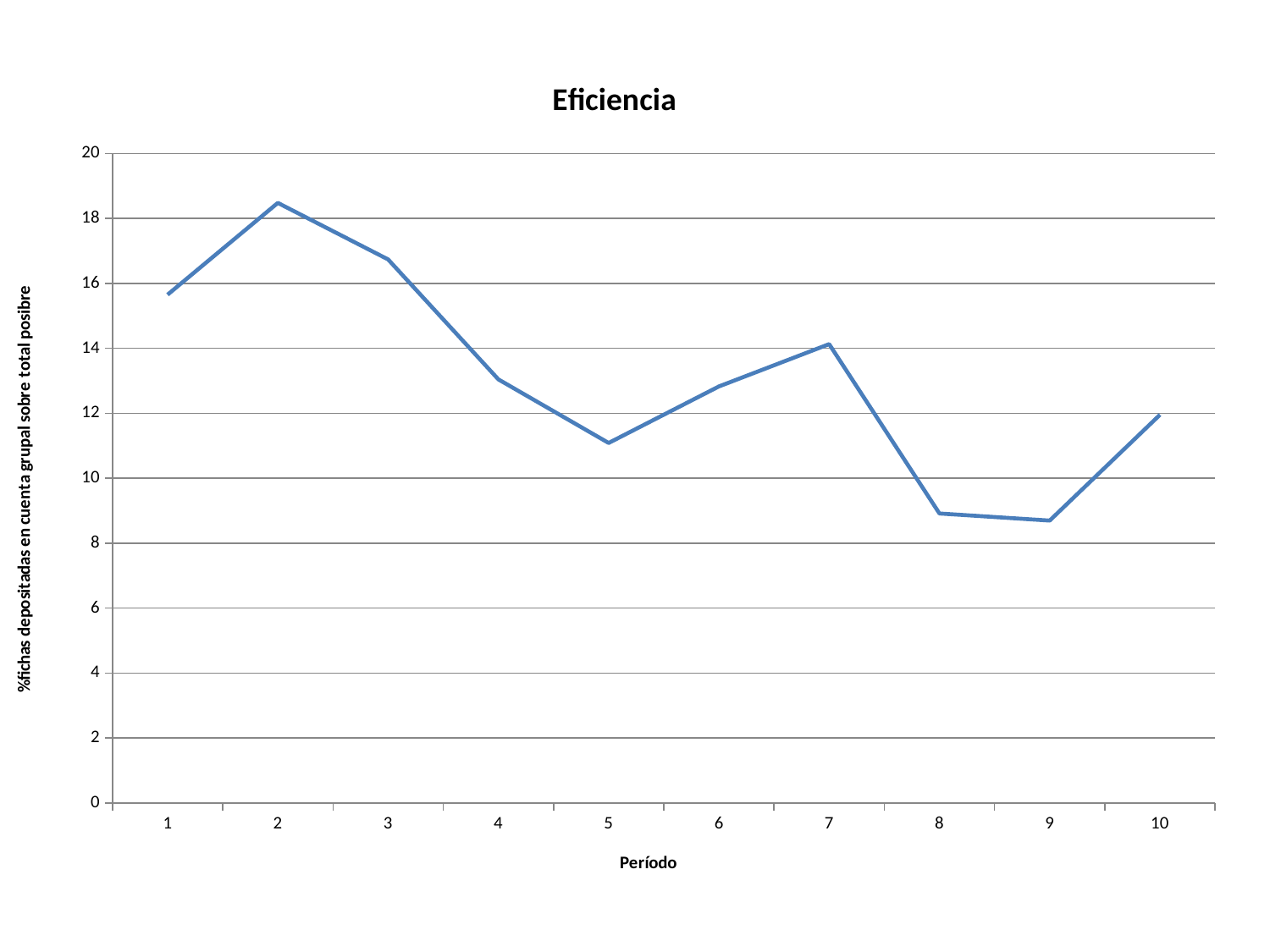
What is the label of the x axis? Período What is the title of the chart? Eficiencia How many periods are plotted on the x axis? 10 Is the value for period 2 greater or less than 18? greater Is the value for period 8 greater or less than 10? less Do the values rise or fall from period 2 to period 5? fall Is the value for period 1 greater or less than 16? less Which has the larger value, period 4 or period 8? period 4 Which period has the highest value? 2 What kind of chart is shown on the slide? line chart Which has the larger value, period 2 or period 5? period 2